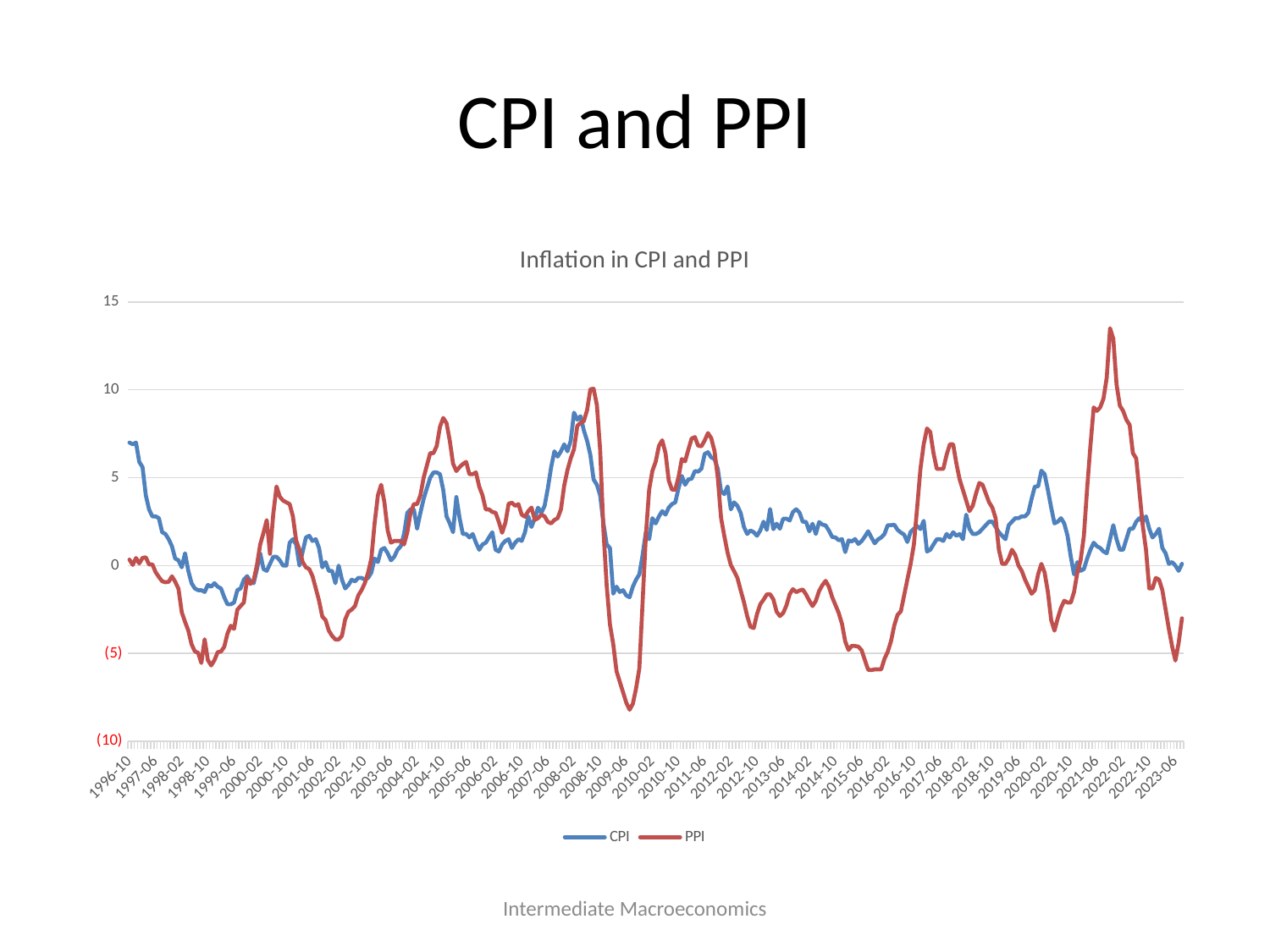
What is the title of the chart? Inflation in CPI and PPI Is the PPI value around 2015-10 greater or less than (5)? less Is the CPI value at the start of the series, 1996-10, greater or less than 5? greater Which series reaches the higher maximum value over the whole period, CPI or PPI? PPI Which series reaches the lower minimum value over the whole period, CPI or PPI? PPI Is the peak value of PPI around 2022-02 greater or less than 10? greater Does the CPI line rise or fall from 1996-10 to 1998-10? fall What colour is the PPI line? red How many series does the legend list? 2 What kind of chart is shown on the slide? line chart